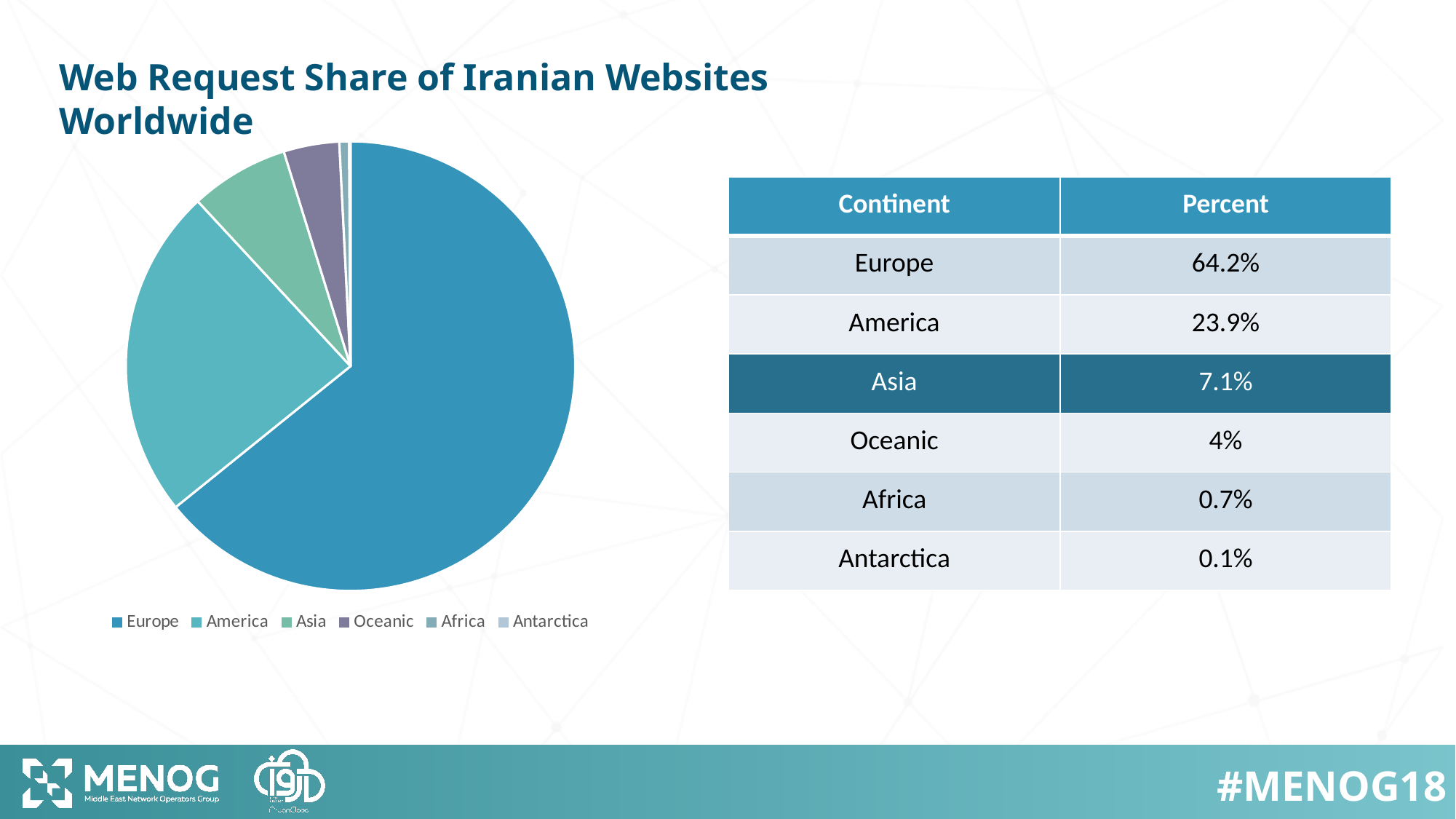
What is the web request share for Oceanic? 4% How many slices does the pie chart have? 6 Which has a larger share, Asia or Oceanic? Asia What is the title of the chart? Web Request Share of Iranian Websites Worldwide What kind of chart is shown on the slide? pie chart What is the web request share for Europe? 64.2% What is the web request share for America? 23.9% Is the share for Europe greater or less than 50%? greater Which continent has the smallest share of web requests? Antarctica What is the web request share for Asia? 7.1% Which continent has the largest share of web requests? Europe What is the difference between the shares of Europe and America? 40.3%